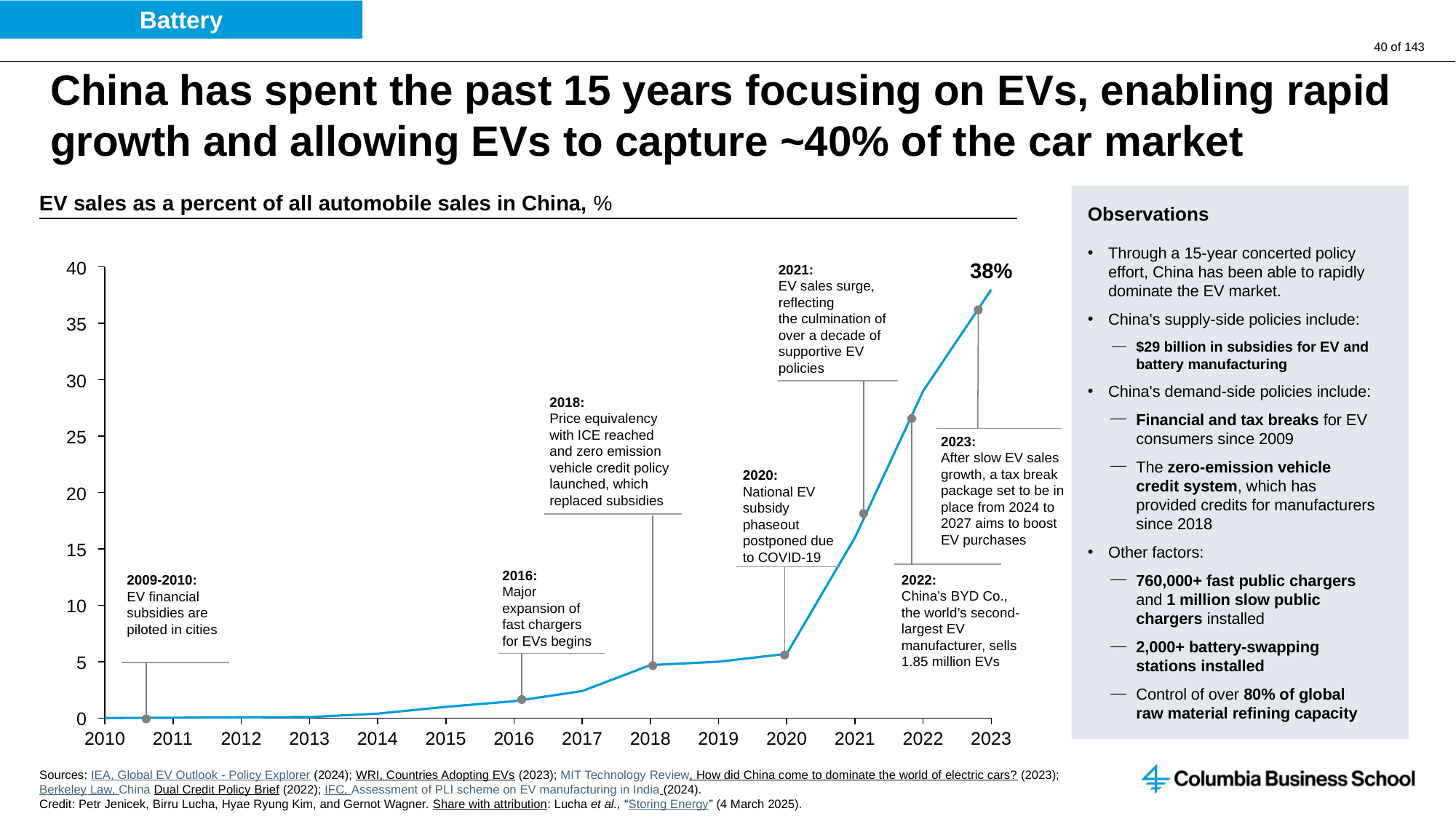
How many years are shown on the x axis of the chart? 14 Is the value for 2018 greater or less than 10? less Which year has the highest EV sales share on the chart? 2023 What type of chart is shown on the slide? line chart Is the value for 2020 greater or less than 10? less What is the EV sales share of all automobile sales in China in 2023, as labelled on the chart? 38% Is the value for 2021 greater or less than 15? greater What is the title of the chart? EV sales as a percent of all automobile sales in China, % Which year has a larger EV sales share, 2021 or 2022? 2022 Does the EV sales share rise or fall from 2010 to 2023? rise